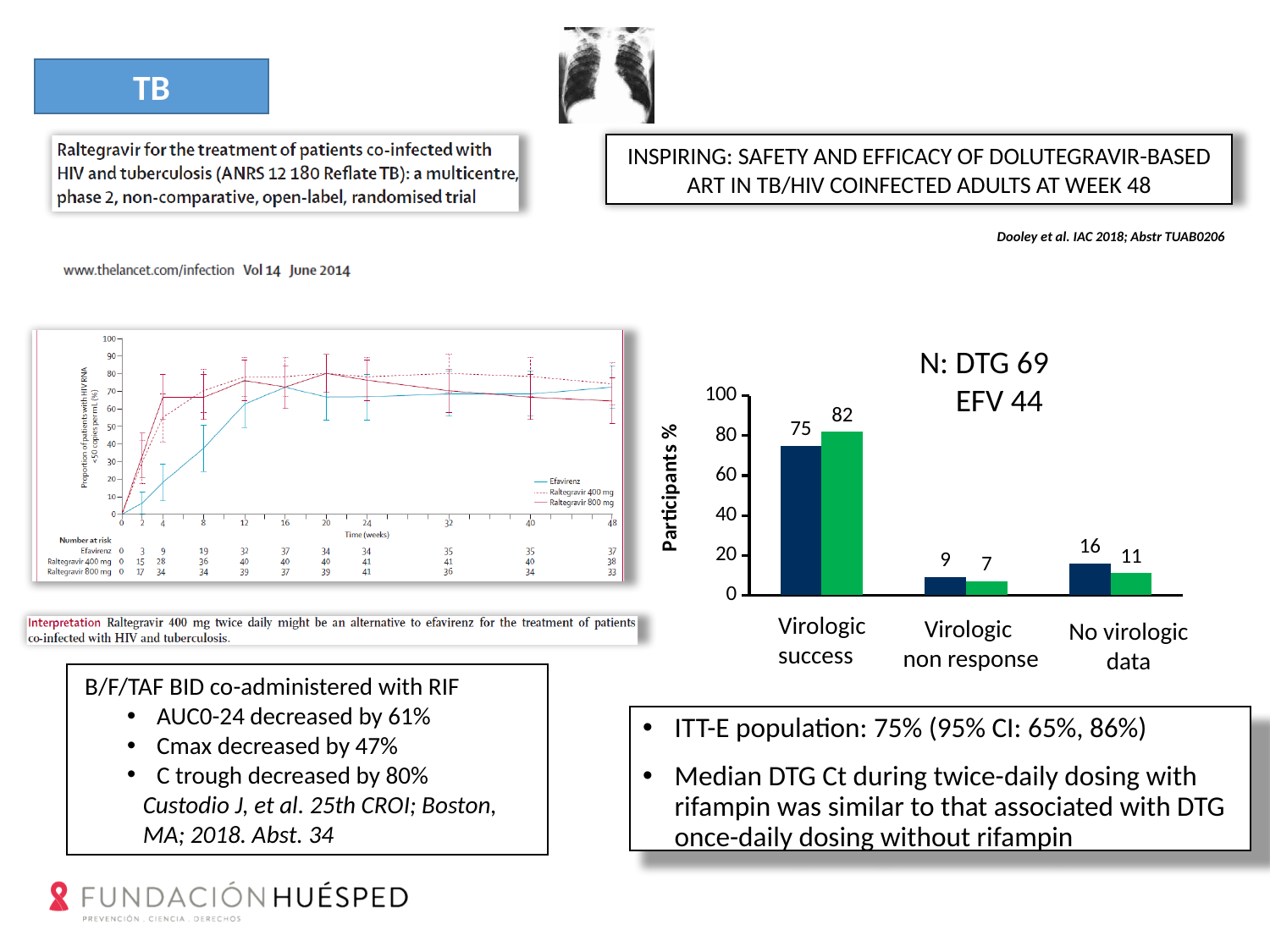
How many series does the legend of the line chart on the left list? 3 On the bar chart on the right, what is the value of the green bar for Virologic success? 82 On the bar chart on the right, which category has the highest values? Virologic success On the bar chart on the right, what is the value of the dark blue bar for No virologic data? 16 On the bar chart on the right, what is the value of the green bar for Virologic non response? 7 On the line chart on the left, is the value for Efavirenz at week 4 greater or less than 30? less On the bar chart on the right, what is the difference between the green and dark blue bars for Virologic success? 7 What kind of chart is the chart on the left of the slide? line chart On the bar chart on the right, what is the label of the y axis? Participants % On the bar chart on the right, how many categories are shown on the x axis? 3 On the bar chart on the right, which is larger for No virologic data, the dark blue bar or the green bar? the dark blue bar On the bar chart on the right, what is the value of the dark blue bar for Virologic success? 75